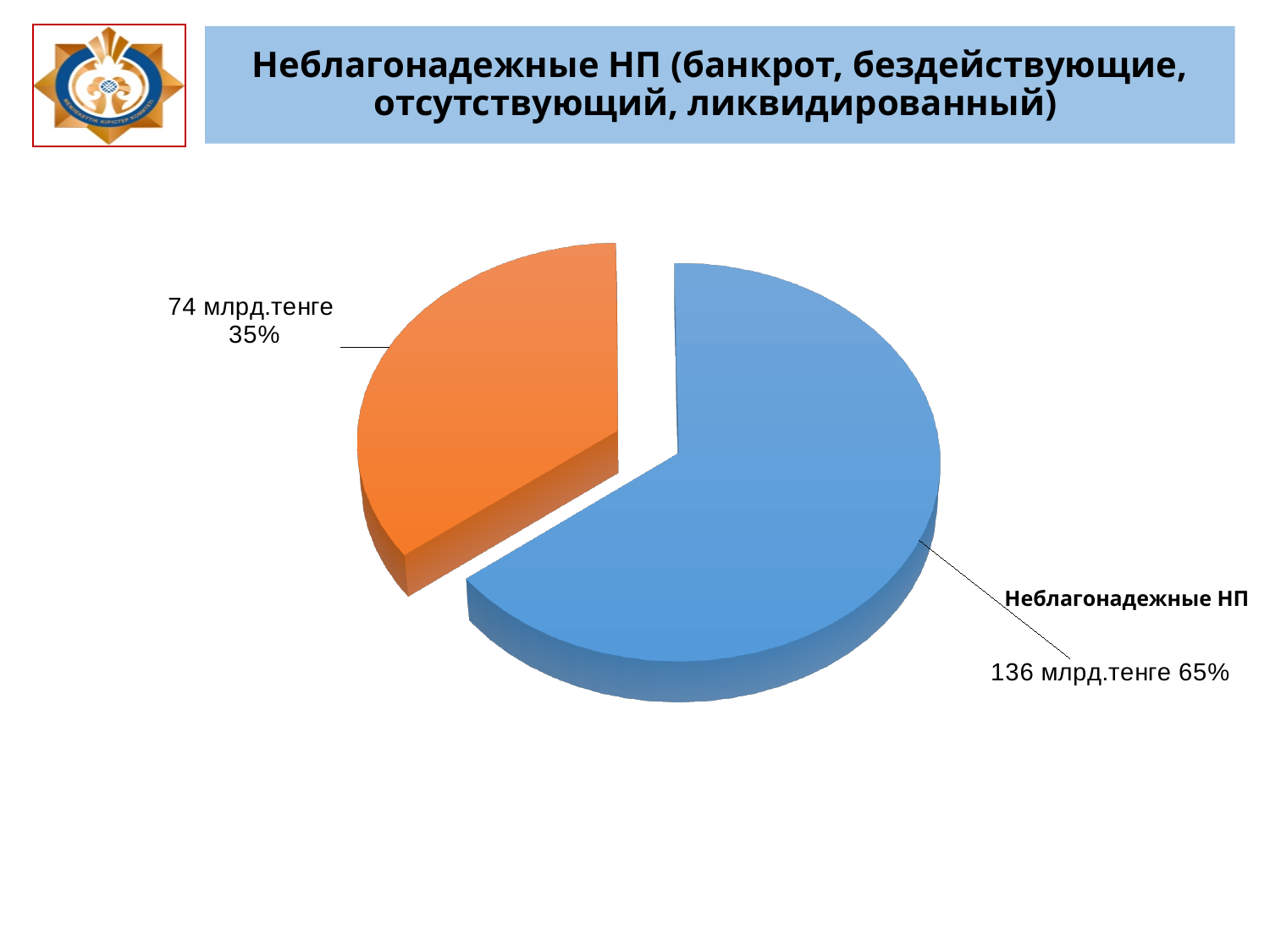
What kind of chart is shown on the slide? pie chart Which slice of the pie chart is the smallest? the orange slice (74 млрд.тенге, 35%) What is the title of the slide containing the pie chart? Неблагонадежные НП (банкрот, бездействующие, отсутствующий, ликвидированный) Which slice of the pie chart is the largest? Неблагонадежные НП (136 млрд.тенге, 65%) Which is larger: the blue slice or the orange slice? the blue slice What share of the pie does the orange slice represent? 35% What share of the pie does the Неблагонадежные НП slice represent? 65% How many slices does the pie chart have? 2 What is the difference in млрд.тенге between the blue slice and the orange slice? 62 млрд.тенге What value is shown for the slice labelled Неблагонадежные НП? 136 млрд.тенге What value is shown for the orange slice of the pie chart? 74 млрд.тенге What colour is the slice labelled Неблагонадежные НП? blue